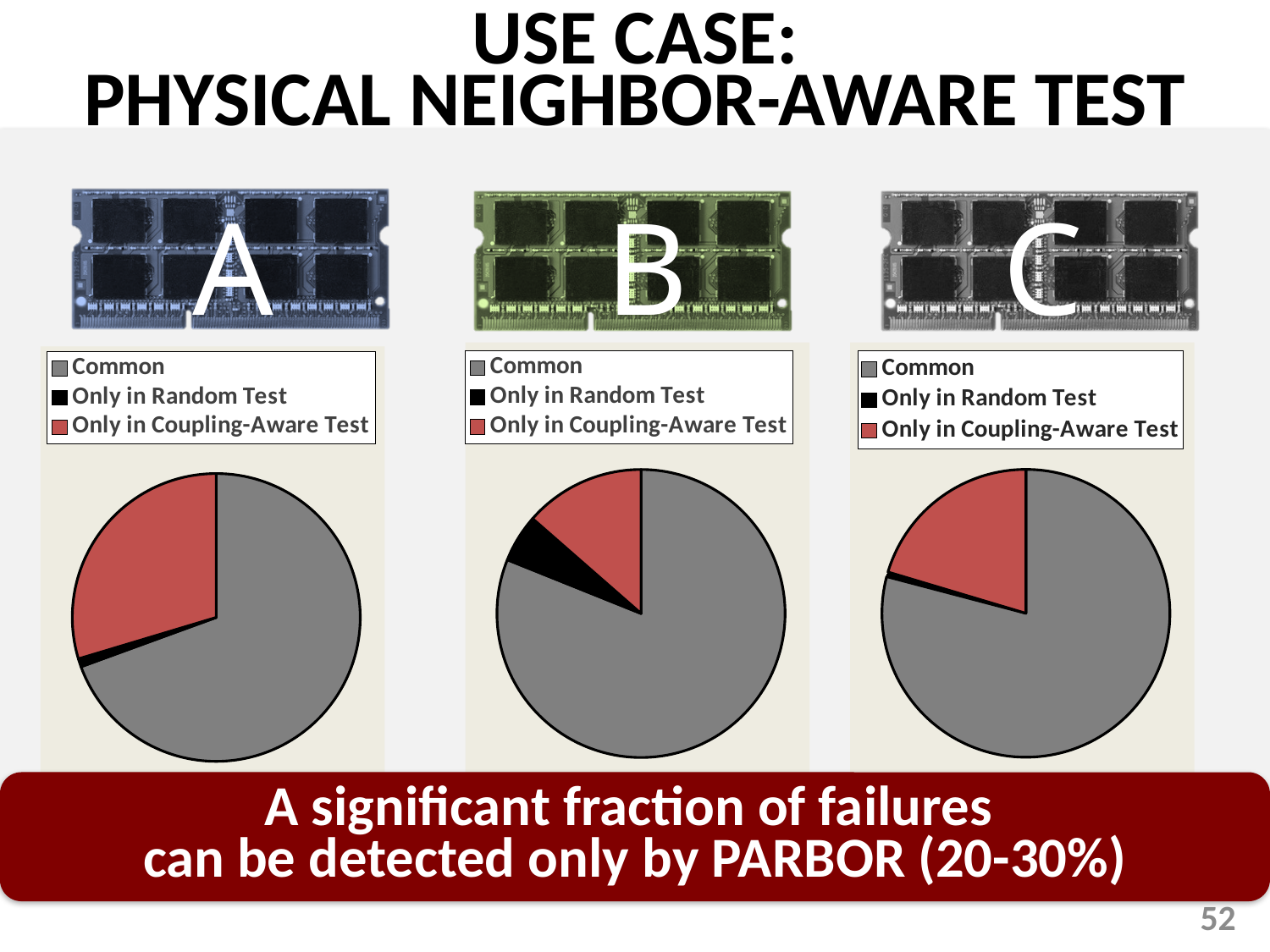
In the pie chart for module C, which slice is larger: Only in Random Test or Only in Coupling-Aware Test? Only in Coupling-Aware Test What colour represents 'Only in Coupling-Aware Test' in the pie charts? Red How many entries does the legend above the pie chart for module A list? 3 What kind of chart is shown under module A? Pie chart In the pie chart for module C, which category has the smallest slice? Only in Random Test What colour represents 'Common' in the pie charts? Gray In the pie chart for module B, which category has the largest slice? Common How many pie charts are on the slide? 3 In the pie chart for module A, which category has the smallest slice? Only in Random Test In the pie chart for module A, which category has the largest slice? Common In the pie chart for module B, which slice is larger: Common or Only in Coupling-Aware Test? Common In the pie chart for module B, which category has the smallest slice? Only in Random Test